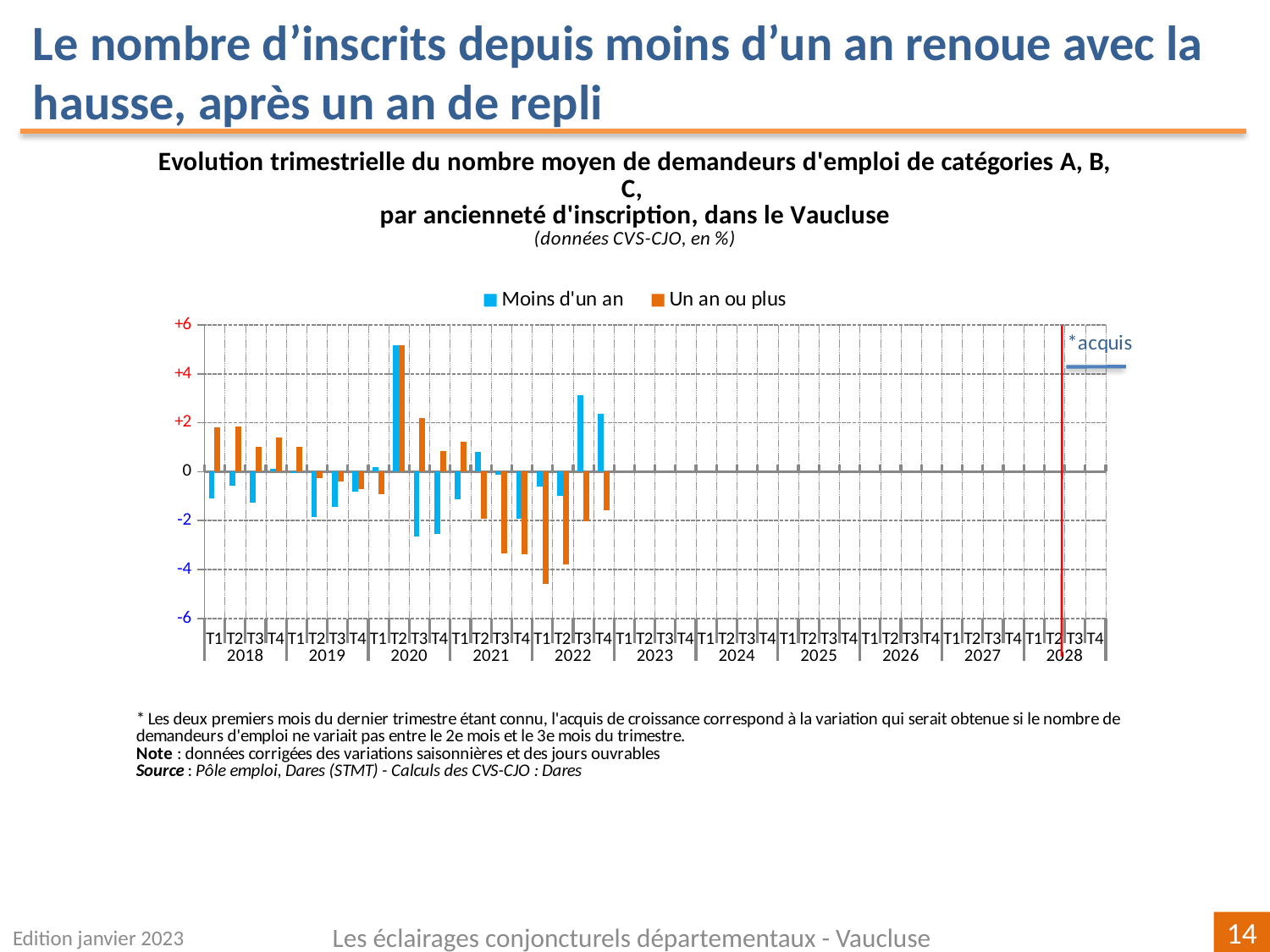
Is the value for 'Un an ou plus' in T1 2022 greater or less than -4? less How many series does the legend list? 2 What are the two series named in the legend? Moins d'un an; Un an ou plus In T3 2020, which series has the larger value, 'Moins d'un an' or 'Un an ou plus'? Un an ou plus In which quarter does the 'Un an ou plus' series reach its lowest value? T1 2022 What kind of chart is shown on the slide? bar chart Is the value for 'Moins d'un an' in T2 2020 greater or less than +4? greater In T3 2022, which series has the larger value, 'Moins d'un an' or 'Un an ou plus'? Moins d'un an In which quarter does the 'Moins d'un an' series reach its highest value? T2 2020 Is the value for 'Un an ou plus' in T3 2021 greater or less than -2? less How many years are labelled along the x axis of the chart? 11